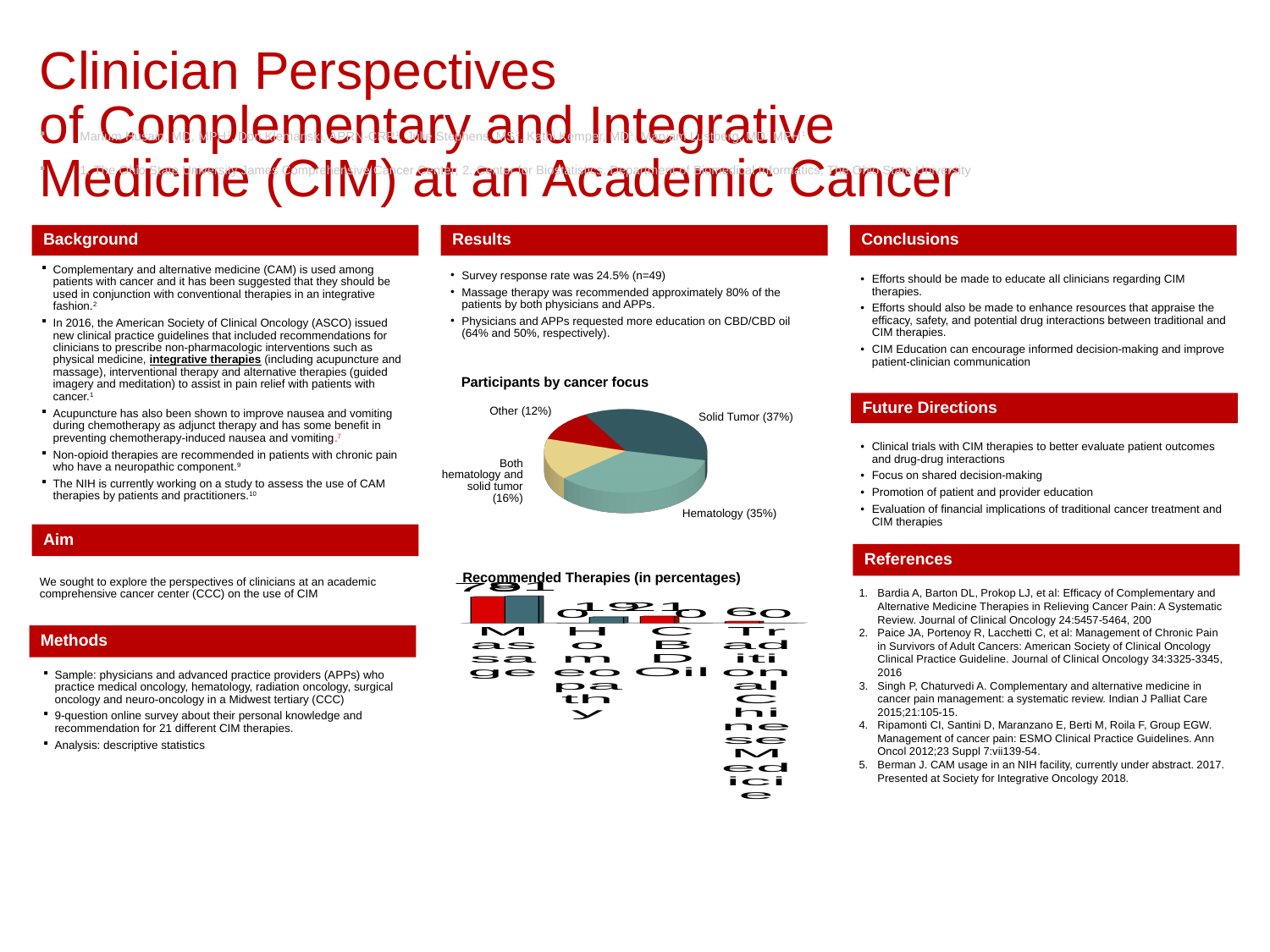
What is the title of the chart located below the 'Participants by cancer focus' pie chart? Recommended Therapies (in percentages) In the 'Participants by cancer focus' pie chart, what percentage of participants have a Hematology focus? 35% In the 'Participants by cancer focus' pie chart, which cancer focus has the largest share of participants? Solid Tumor How many categories are shown in the 'Participants by cancer focus' pie chart? 4 What kind of chart is 'Recommended Therapies (in percentages)'? Bar chart In the 'Participants by cancer focus' pie chart, what is the difference in percentage points between Solid Tumor and Other? 25 In the 'Participants by cancer focus' pie chart, which cancer focus has the smallest share of participants? Other In the 'Participants by cancer focus' pie chart, what percentage of participants have a Solid Tumor focus? 37% In the 'Participants by cancer focus' pie chart, what percentage of participants fall under 'Other'? 12% What kind of chart is 'Participants by cancer focus'? Pie chart In the 'Participants by cancer focus' pie chart, what percentage of participants focus on both hematology and solid tumor? 16% In the 'Participants by cancer focus' pie chart, which is larger: the share for Hematology or the share for Both hematology and solid tumor? Hematology